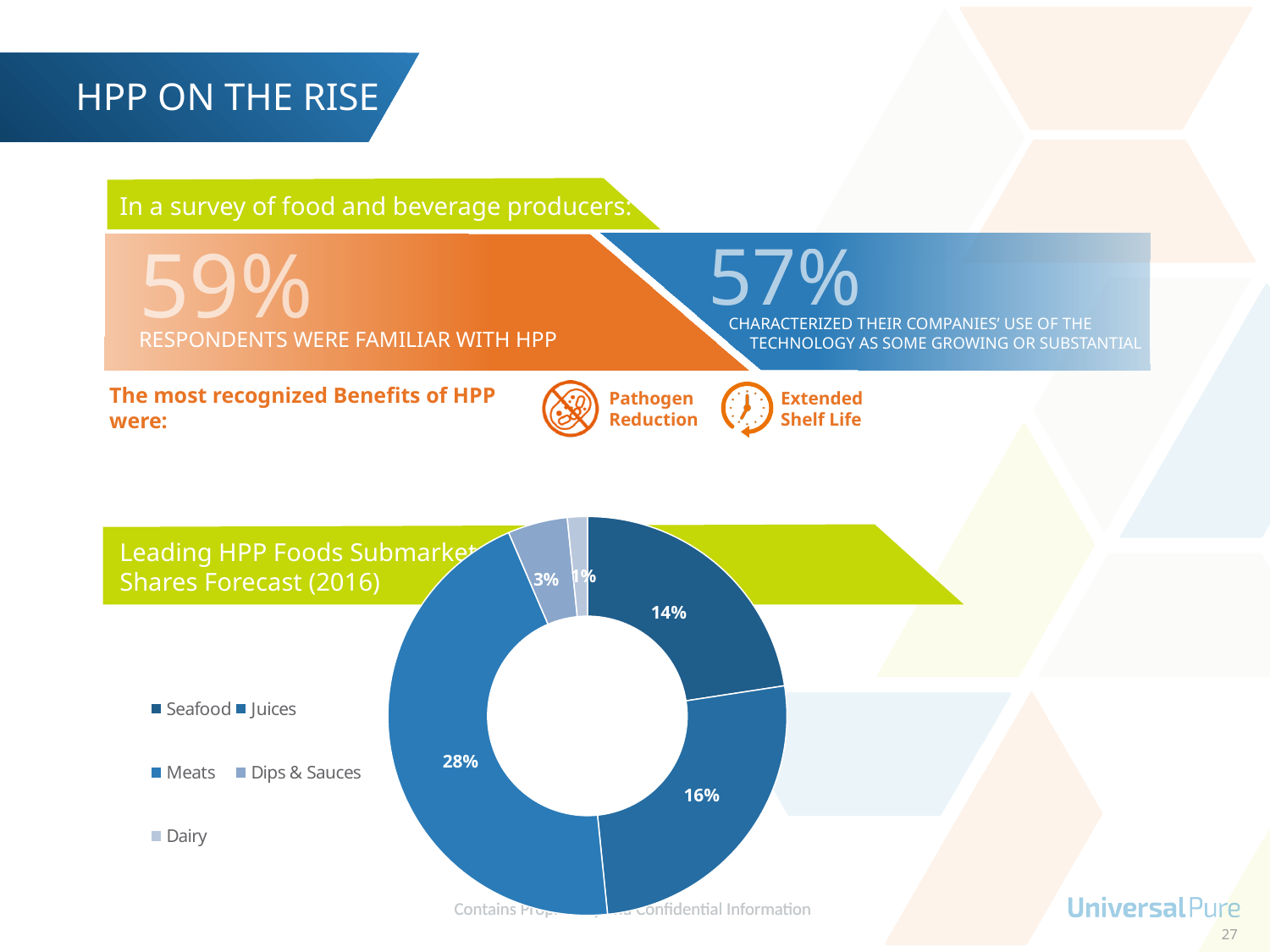
How many categories does the chart legend list? 5 What share of the doughnut chart is labeled for Juices? 16% Which has the larger share in the chart, Seafood or Juices? Juices What share of the doughnut chart is labeled for Seafood? 14% Is the Seafood share greater or less than 10%? greater What is the combined share of the slices labeled 3% and 1%? 4% What kind of chart is shown on the slide? Doughnut (pie) chart Which category is listed first in the chart legend? Seafood What is the title of the chart on the slide? Leading HPP Foods Submarket Shares Forecast (2016) What is the smallest percentage label shown on the doughnut chart? 1% What is the difference in percentage points between the Juices share and the Seafood share? 2 What is the largest percentage label printed on the doughnut chart? 28%